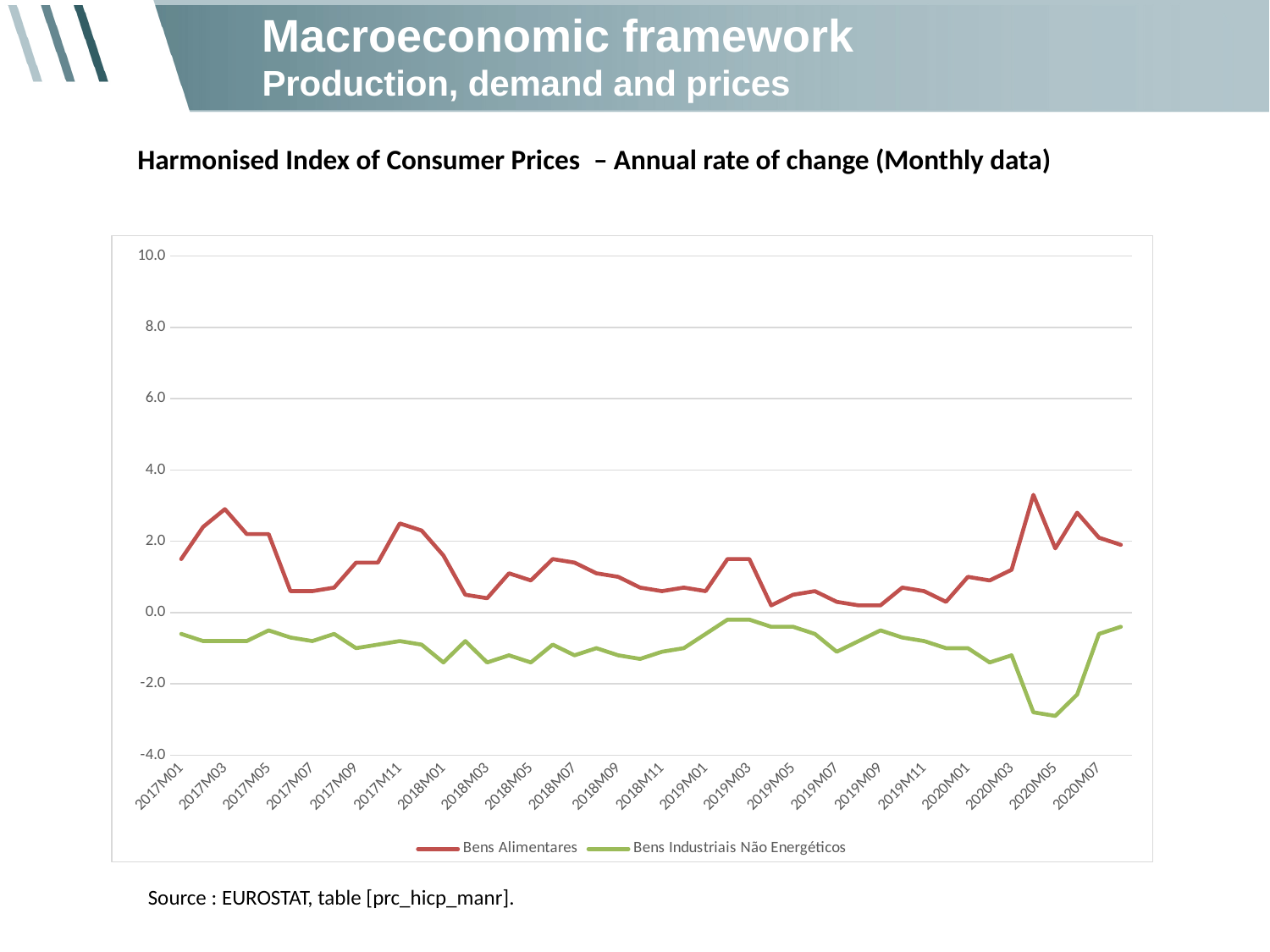
Is the value for Bens Alimentares at 2019M05 greater or less than 2.0? less Is the value for Bens Industriais Não Energéticos at 2019M03 greater or less than -2.0? greater Is the value for Bens Industriais Não Energéticos at 2020M05 greater or less than -2.0? less How many series does the legend list? 2 Which series reaches the lowest value anywhere on the chart? Bens Industriais Não Energéticos What kind of chart is shown on the slide? Line chart At 2020M05, which series has the higher value, Bens Alimentares or Bens Industriais Não Energéticos? Bens Alimentares What are the two series named in the legend? Bens Alimentares and Bens Industriais Não Energéticos What is the title of the chart? Harmonised Index of Consumer Prices – Annual rate of change (Monthly data) Does the Bens Industriais Não Energéticos line rise or fall between 2020M05 and 2020M07? rise